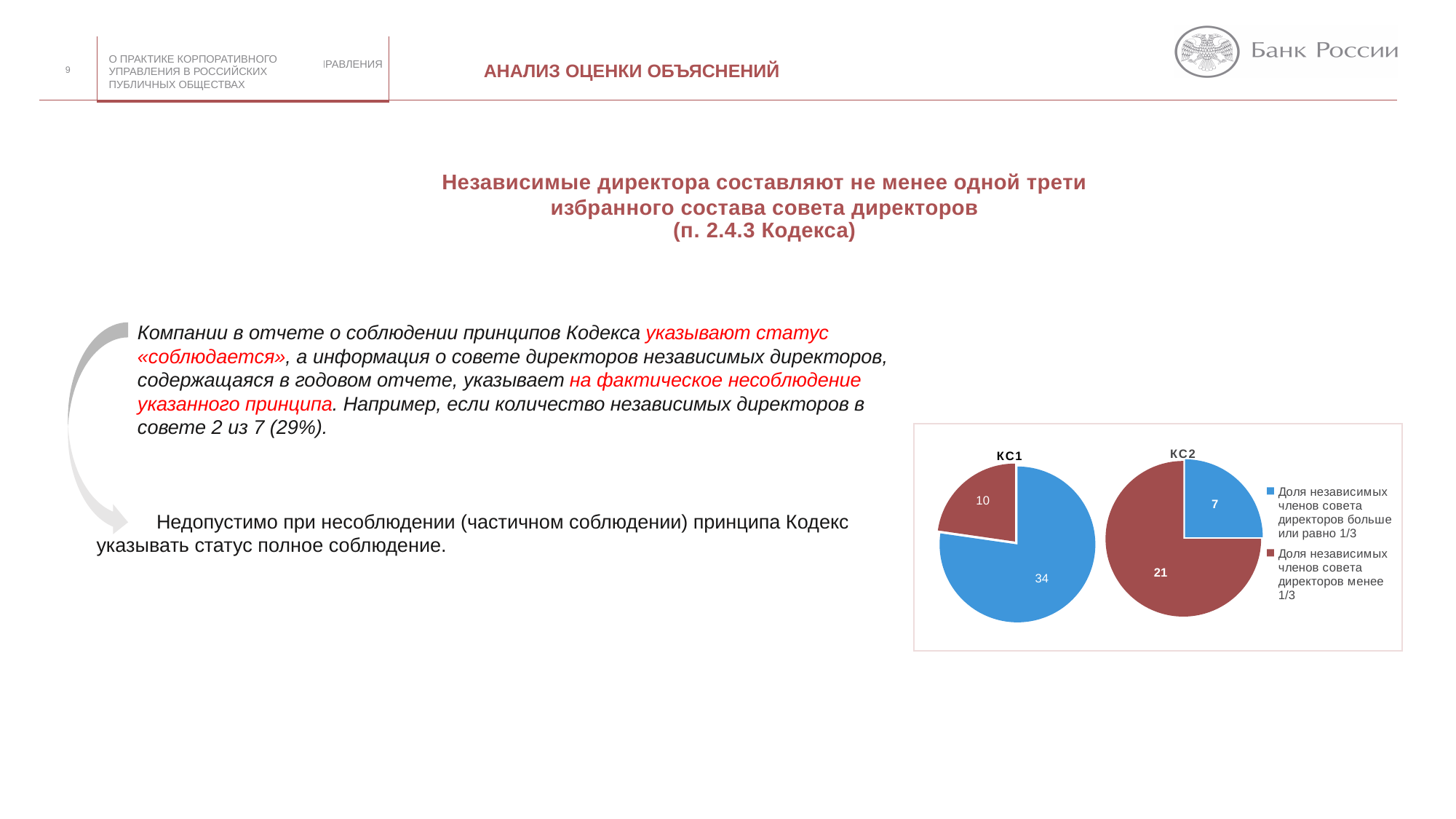
In the КС2 pie chart, what share of the total does the red slice (21) represent? 75% In the КС2 pie chart, what is the difference between the red slice (21) and the blue slice (7)? 14 In the КС1 pie chart, which slice is the largest? Доля независимых членов совета директоров больше или равно 1/3 In the КС1 pie chart, what is the value for the share of independent board members greater than or equal to 1/3 (blue slice)? 34 In the КС1 pie chart, what is the value for the share of independent board members less than 1/3 (red slice)? 10 Which is larger: the blue slice in the КС1 pie chart or the blue slice in the КС2 pie chart? КС1 In the КС2 pie chart, which slice is the smallest? Доля независимых членов совета директоров больше или равно 1/3 How many entries does the legend list for the pie charts? 2 What kind of charts are shown on the slide? Pie charts In the КС1 pie chart, what is the difference between the blue slice (34) and the red slice (10)? 24 In the КС2 pie chart, what is the value for the share of independent board members less than 1/3 (red slice)? 21 In the КС2 pie chart, what is the value for the share of independent board members greater than or equal to 1/3 (blue slice)? 7